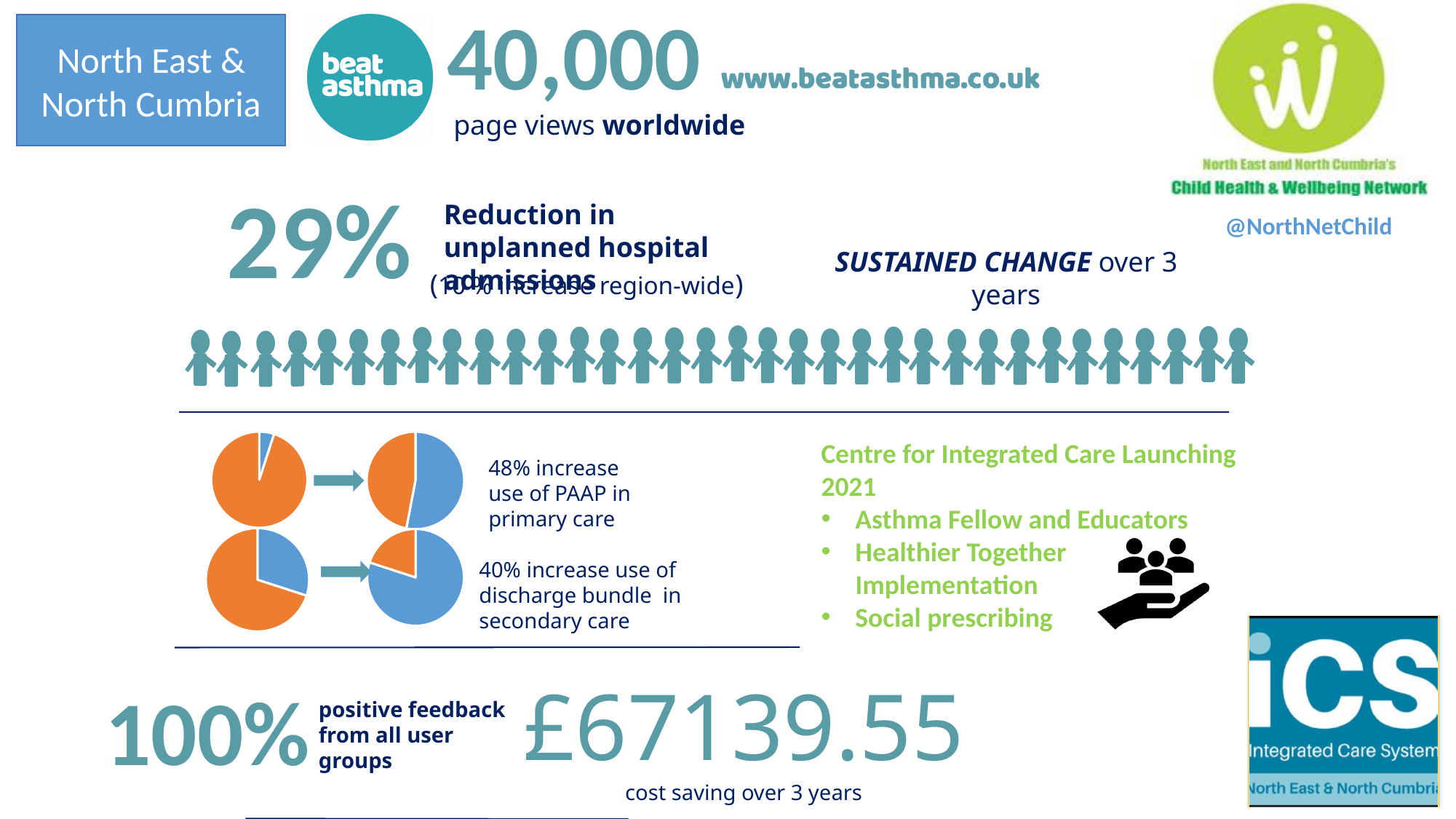
In the bottom-right pie chart (after the arrow), which colour slice is larger, orange or blue? Blue In the top-left pie chart (before the arrow), which colour slice is larger, orange or blue? Orange How many pie charts are shown on the slide? 4 What two colours are used for the slices in the pie charts? Orange and blue What kind of charts are shown in the lower-left section of the slide? Pie charts In the bottom-right pie chart, is the blue slice greater or less than half of the pie? greater In the top-left pie chart, is the blue slice greater or less than half of the pie? less From the left pie to the right pie in the bottom row, does the orange share increase or decrease? Decrease From the left pie to the right pie in the top row, does the blue share increase or decrease? Increase What caption accompanies the top pair of pie charts? 48% increase use of PAAP in primary care In the bottom-left pie chart (before the arrow), which colour slice is larger, orange or blue? Orange